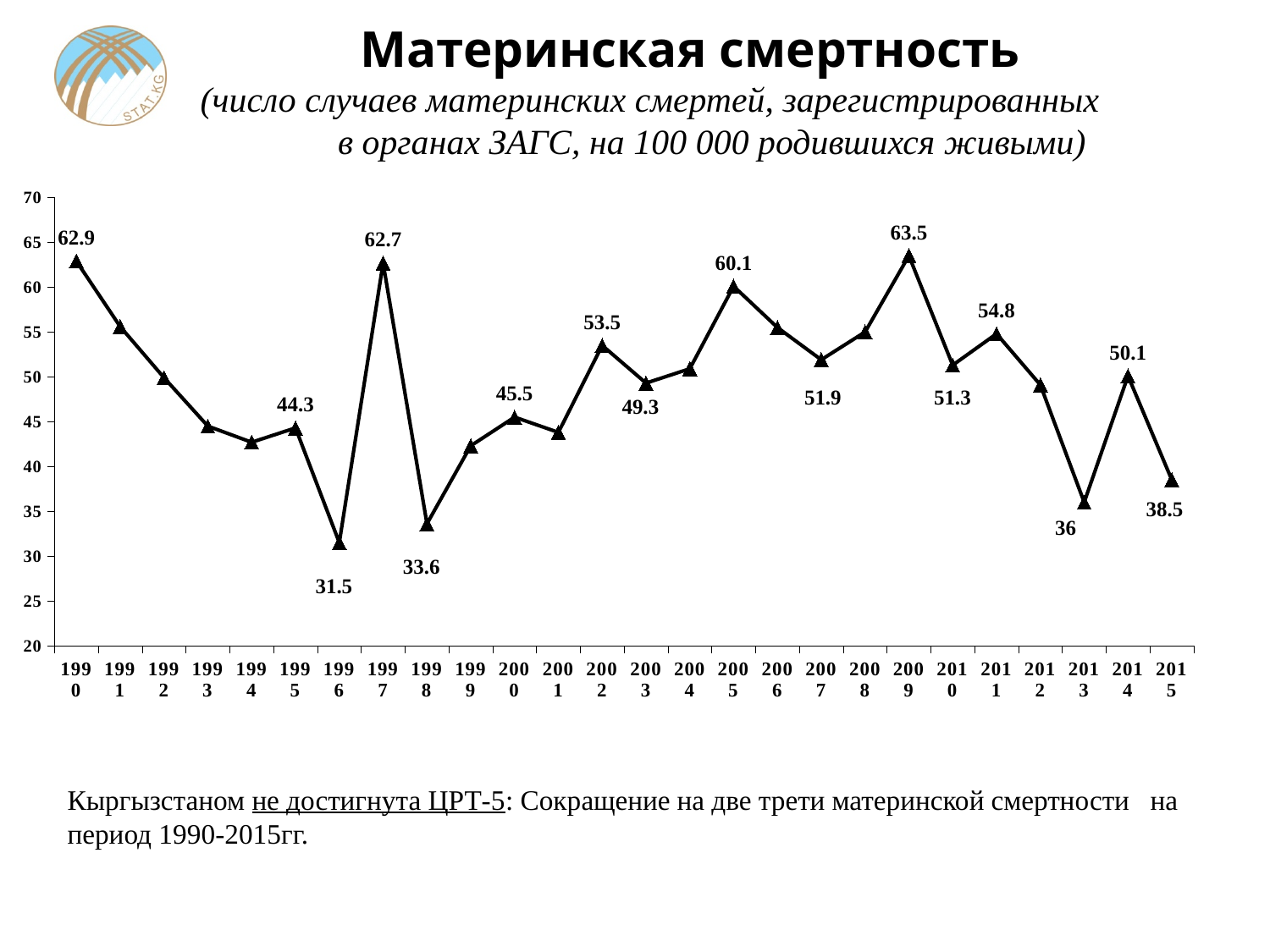
How many years are plotted on the x axis? 26 Which year has the lowest maternal mortality value on the chart? 1996 Which year has the highest maternal mortality value on the chart? 2009 Which is larger, the value for 1997 or the value for 2005? 1997 What is the maternal mortality value shown for 1990? 62.9 What is the value shown for 2015? 38.5 What is the difference between the values for 1990 and 2015? 24.4 What is the value shown for 2009? 63.5 Is the value for 1999 greater or less than 45? less What is the value shown for 1996? 31.5 What kind of chart is shown on the slide? line chart Is the value for 1991 greater or less than 50? greater